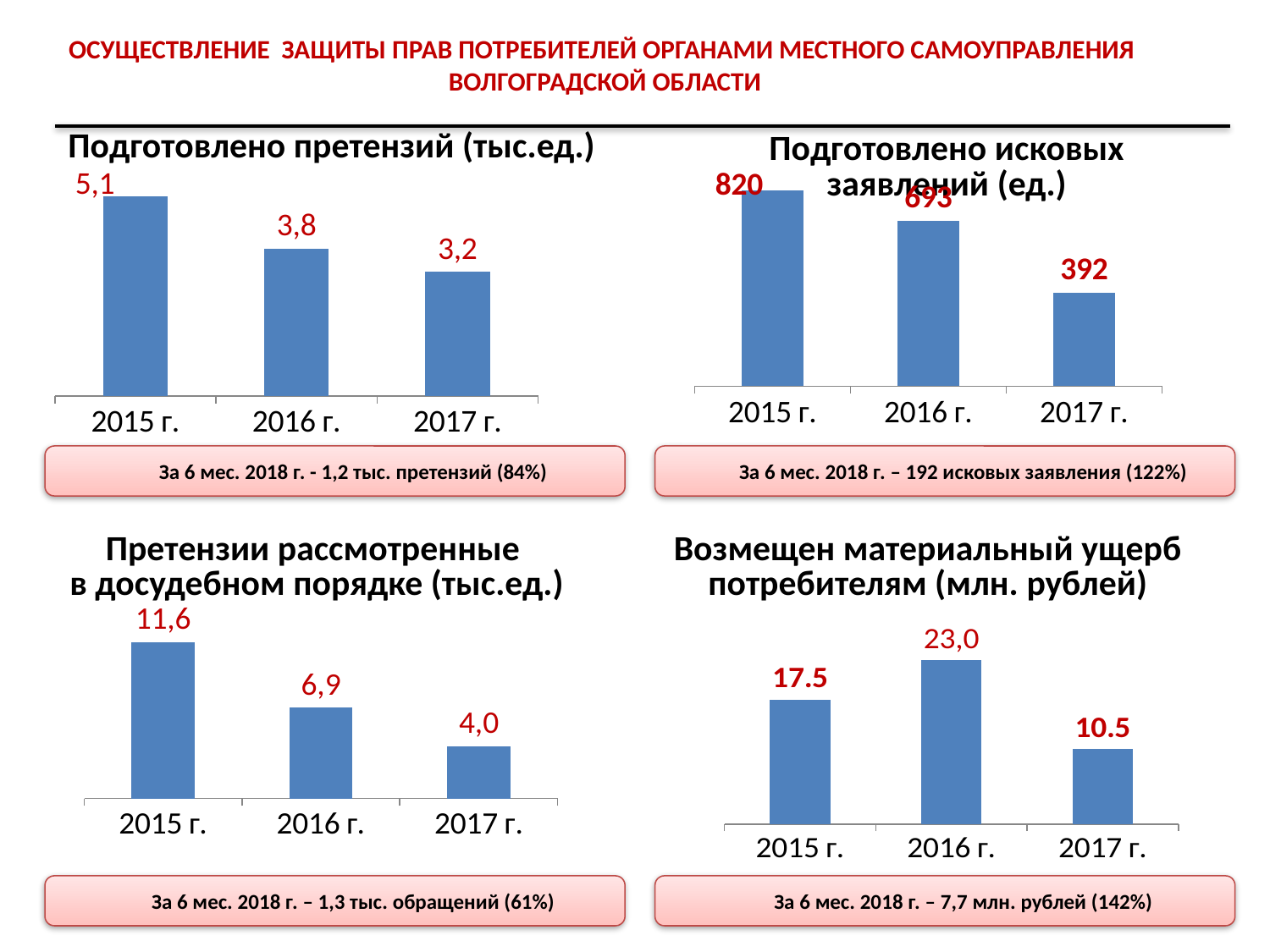
In the chart "Подготовлено исковых заявлений (ед.)", what is the difference between the values for 2015 г. and 2017 г.? 428 In the chart "Подготовлено исковых заявлений (ед.)", what is the value for 2017 г.? 392 In the chart "Претензии рассмотренные в досудебном порядке (тыс.ед.)", what is the value for 2016 г.? 6,9 How many charts are shown on the slide? 4 In the chart "Подготовлено претензий (тыс.ед.)", do the values rise or fall from 2015 г. to 2017 г.? Fall In the chart "Возмещен материальный ущерб потребителям (млн. рублей)", which year has the highest value? 2016 г. In the chart "Претензии рассмотренные в досудебном порядке (тыс.ед.)", what is the difference between the values for 2015 г. and 2016 г.? 4,7 What type of chart is "Претензии рассмотренные в досудебном порядке (тыс.ед.)"? Bar chart In the chart "Подготовлено исковых заявлений (ед.)", which year has the lowest value? 2017 г. How many years are shown in the chart "Подготовлено претензий (тыс.ед.)"? 3 In the chart "Подготовлено претензий (тыс.ед.)", what is the value for 2015 г.? 5,1 In the chart "Возмещен материальный ущерб потребителям (млн. рублей)", which is larger, the value for 2015 г. or 2017 г.? 2015 г.